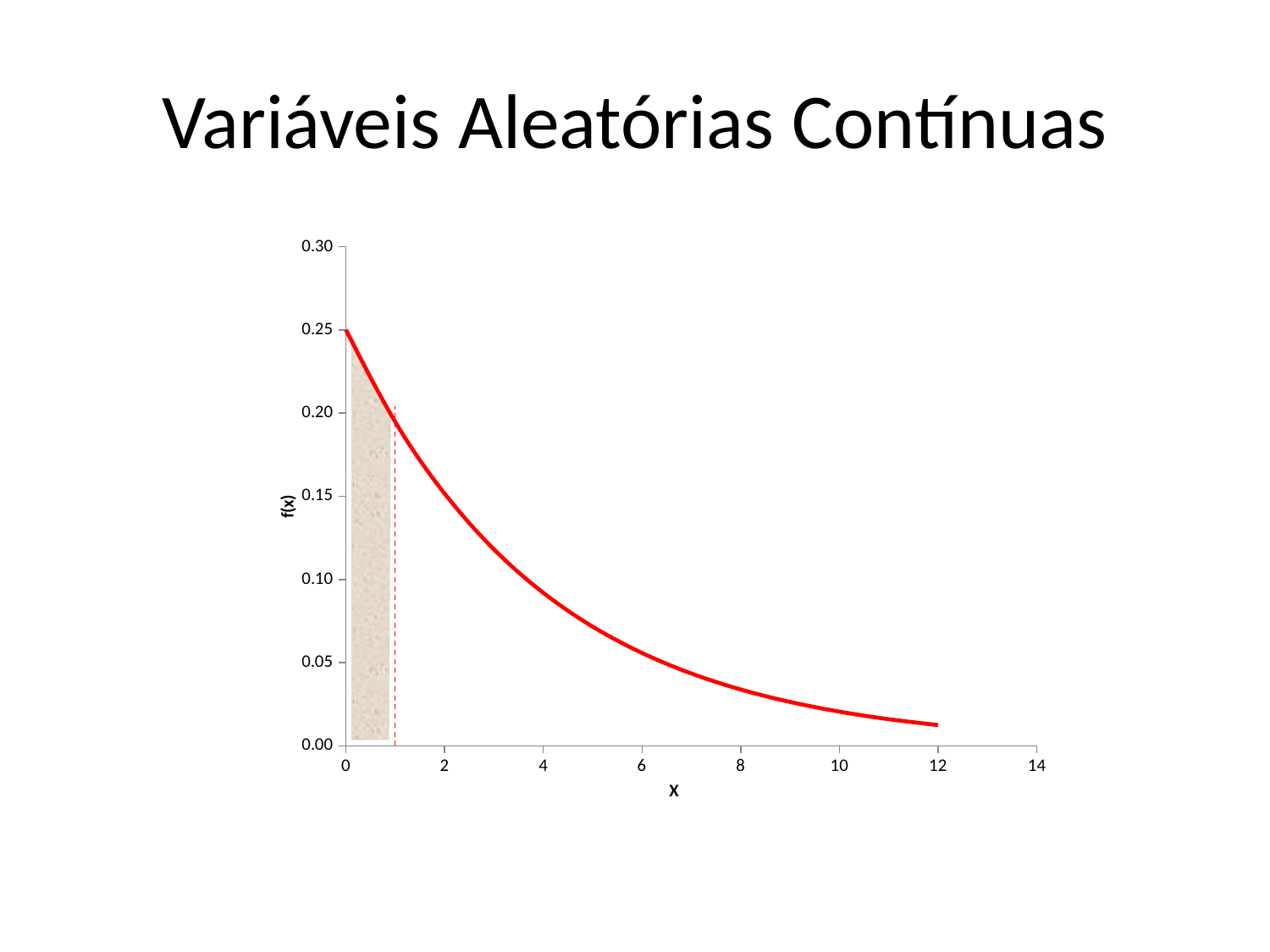
Is the value of f(x) at x = 8 greater or less than 0.05? less Do the values of f(x) rise or fall as x increases? fall Is the value of f(x) at x = 12 greater or less than 0.05? less What kind of chart is shown on the slide? line chart Is the value of f(x) at x = 1 greater or less than 0.25? less What is the label of the vertical axis? f(x) Which is larger, f(x) at x = 2 or f(x) at x = 8? x = 2 At which value of x is f(x) highest? 0 What is the label of the horizontal axis? x What is the highest value shown on the vertical axis? 0.30 What is the value of f(x) at x = 0? 0.25